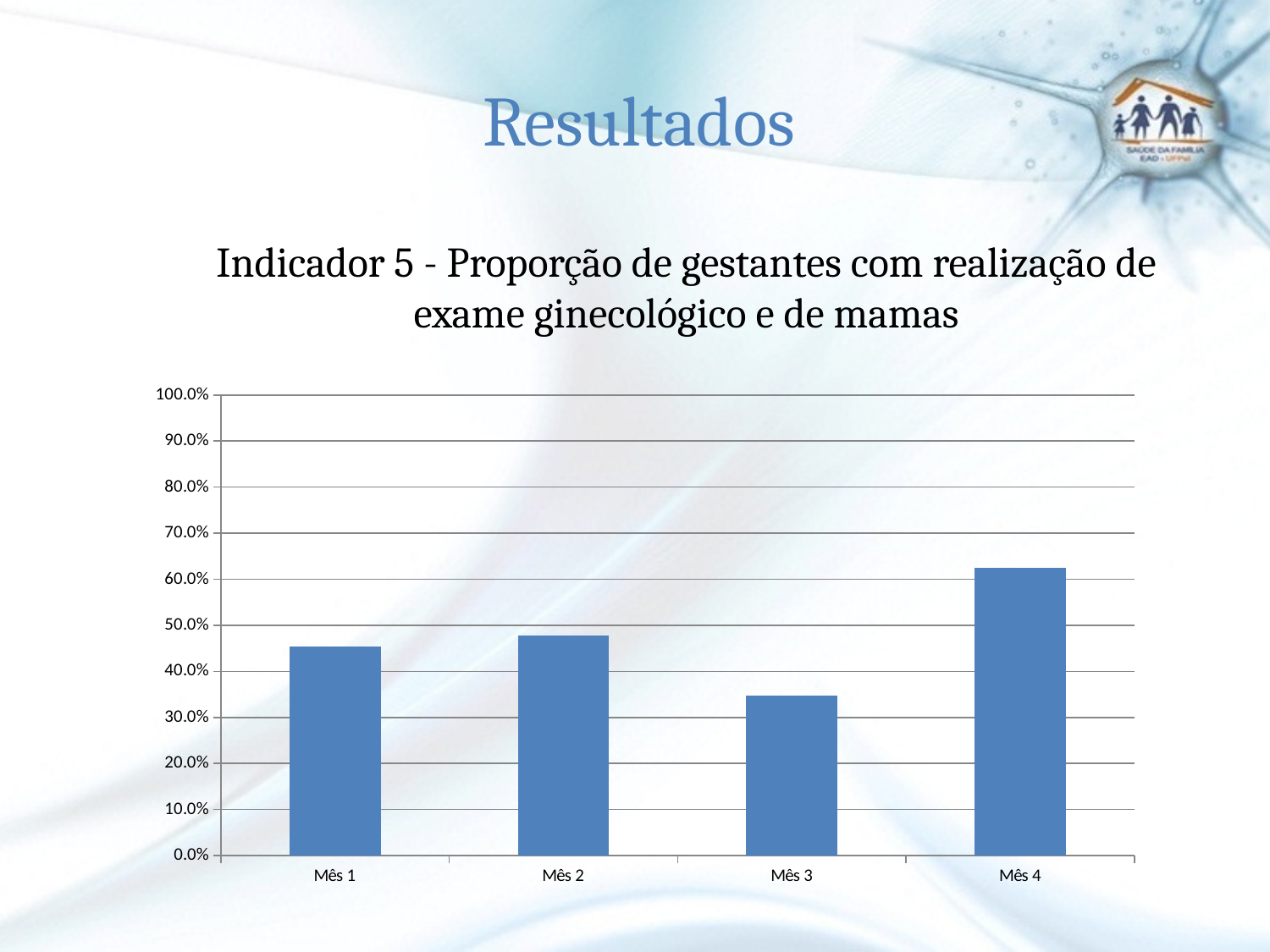
Is the value for Mês 3 greater or less than 40.0%? less Which month has the highest proportion? Mês 4 Which is larger, the value for Mês 4 or the value for Mês 2? Mês 4 Is the value for Mês 3 greater or less than 30.0%? greater Is the value for Mês 1 greater or less than 40.0%? greater What is the title of the chart on the slide? Indicador 5 - Proporção de gestantes com realização de exame ginecológico e de mamas How many categories (months) are shown on the x axis? 4 Which is larger, the value for Mês 1 or the value for Mês 3? Mês 1 What kind of chart is shown on the slide? bar chart Which month has the lowest proportion? Mês 3